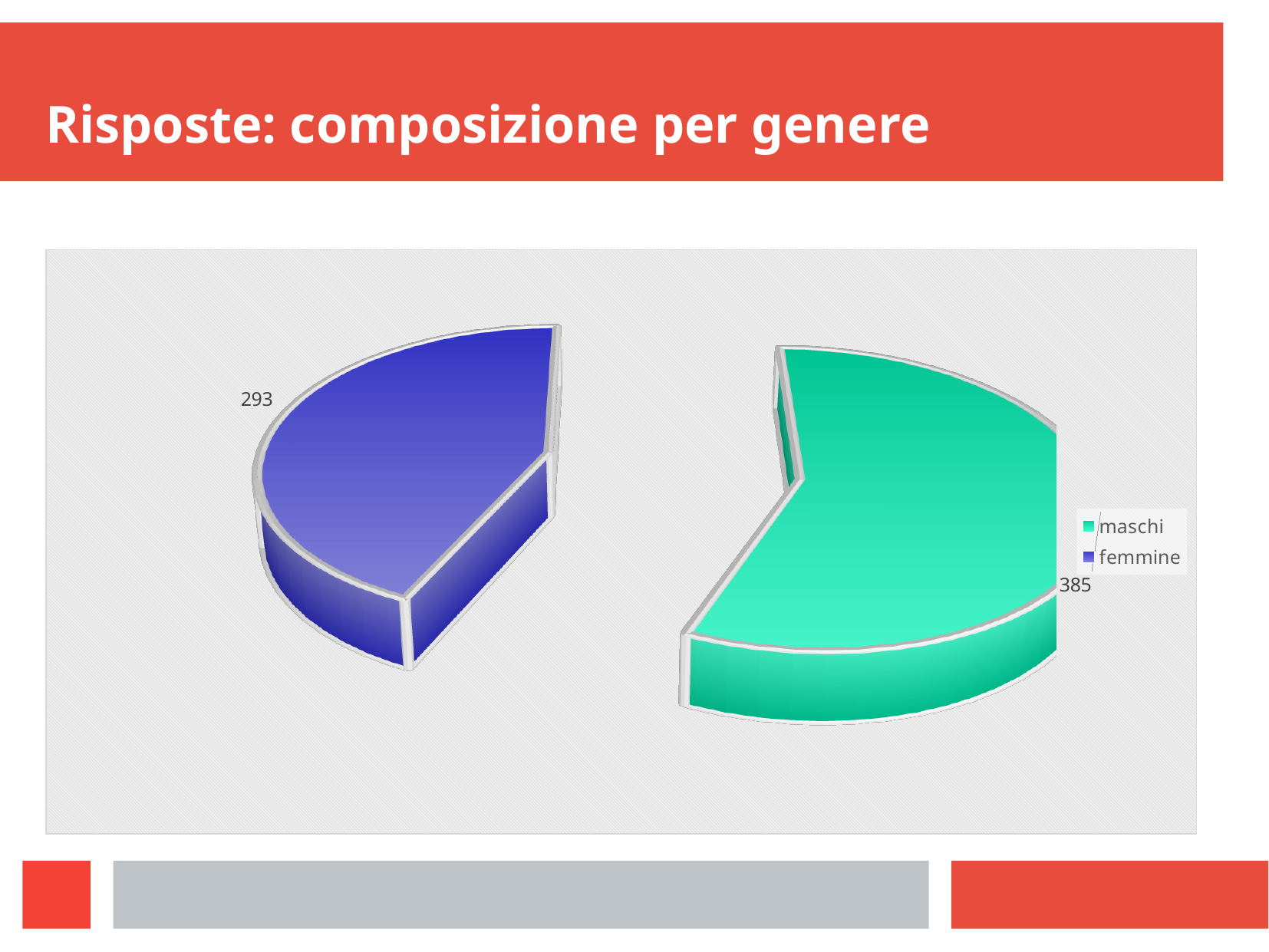
What is the value for femmine? 293 What is the difference between the values for maschi and femmine? 92 Which is larger, the value for maschi or the value for femmine? maschi What kind of chart is shown on the slide? pie chart Which category has the smallest slice? femmine What share of the pie does the maschi slice represent, to the nearest percent? 57% What is the value for maschi? 385 What colour is the femmine slice? blue Which category has the largest slice? maschi What is the total of the two slices? 678 How many entries does the legend list? 2 How many slices does the pie chart have? 2